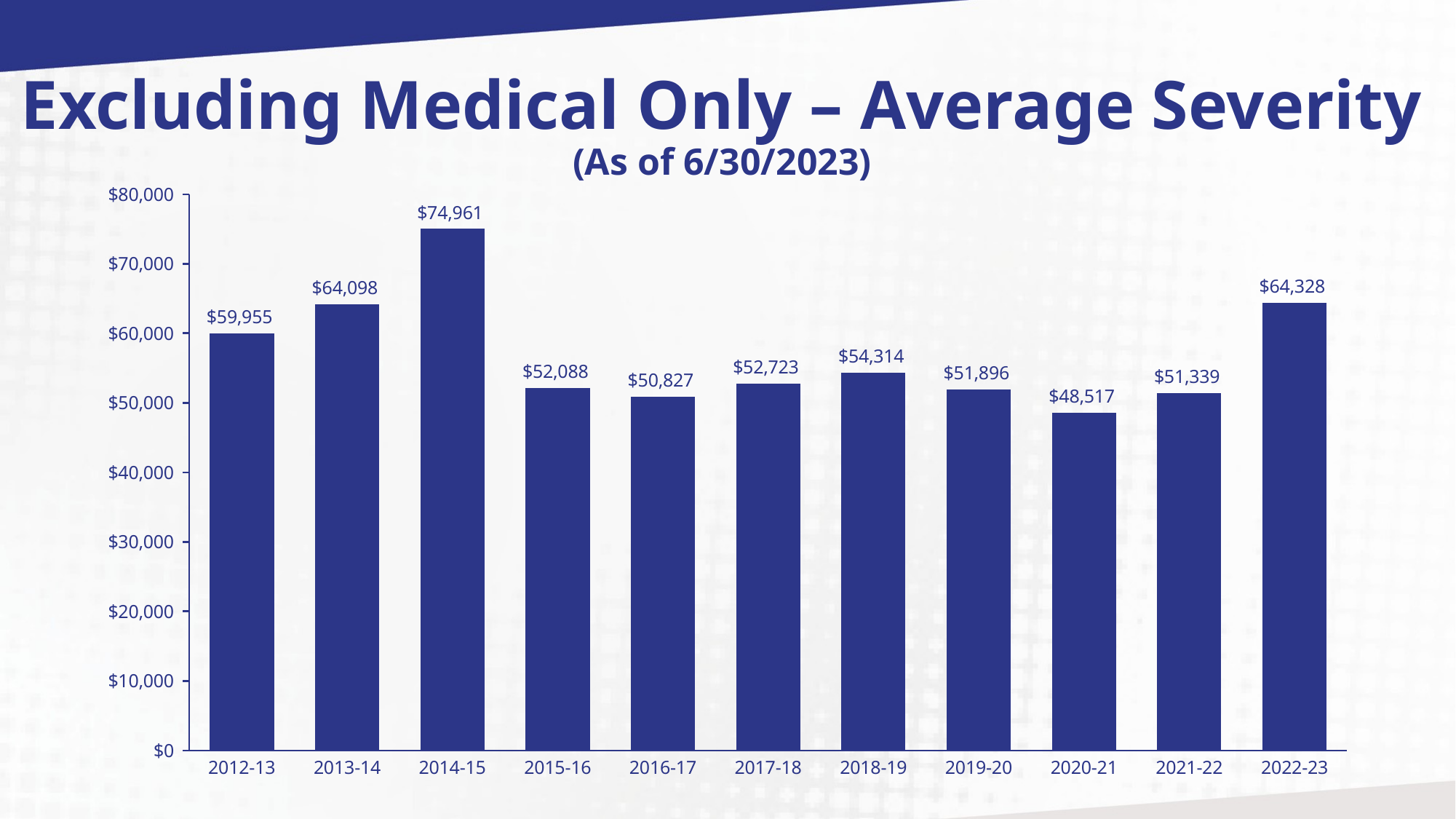
What is the difference between the average severity for 2014-15 and 2013-14? $10,863 How many years are shown on the x axis? 11 What is the average severity for 2014-15? $74,961 Is the value for 2020-21 greater or less than $50,000? less Which year has the highest average severity? 2014-15 What is the average severity for 2022-23? $64,328 What is the average severity for 2020-21? $48,517 What is the difference between the average severity for 2022-23 and 2021-22? $12,989 What kind of chart is shown on the slide? bar chart Which is larger, the average severity for 2012-13 or for 2015-16? 2012-13 Which year has the lowest average severity? 2020-21 Do the values rise or fall from 2014-15 to 2016-17? fall